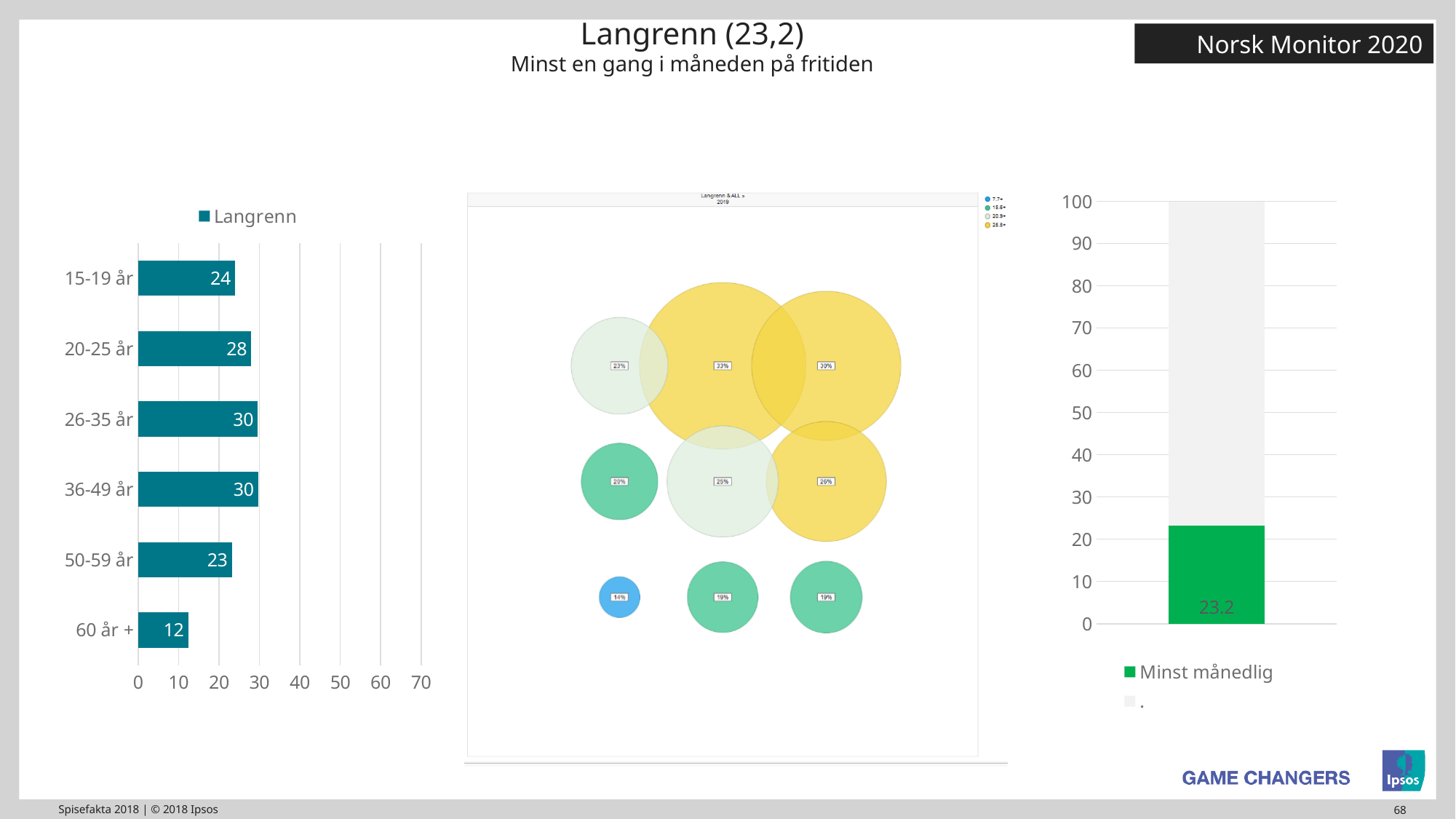
In the left bar chart, what is the value for 20-25 år? 28 In the left bar chart, what is the difference between the values for 20-25 år and 15-19 år? 4 In the left bar chart, what is the difference between the values for 26-35 år and 60 år +? 18 In the left bar chart, what is the value for 60 år +? 12 In the left bar chart, which is larger, the value for 15-19 år or for 50-59 år? 15-19 år What kind of chart is the left chart? bar chart How many age groups are shown in the left bar chart? 6 In the right chart, what is the value for Minst månedlig? 23.2 In the left bar chart, which age group has the lowest value? 60 år + How many series does the legend of the right chart list? 2 What series name is shown in the legend of the left bar chart? Langrenn In the right chart, is the value for Minst månedlig greater or less than 30? less